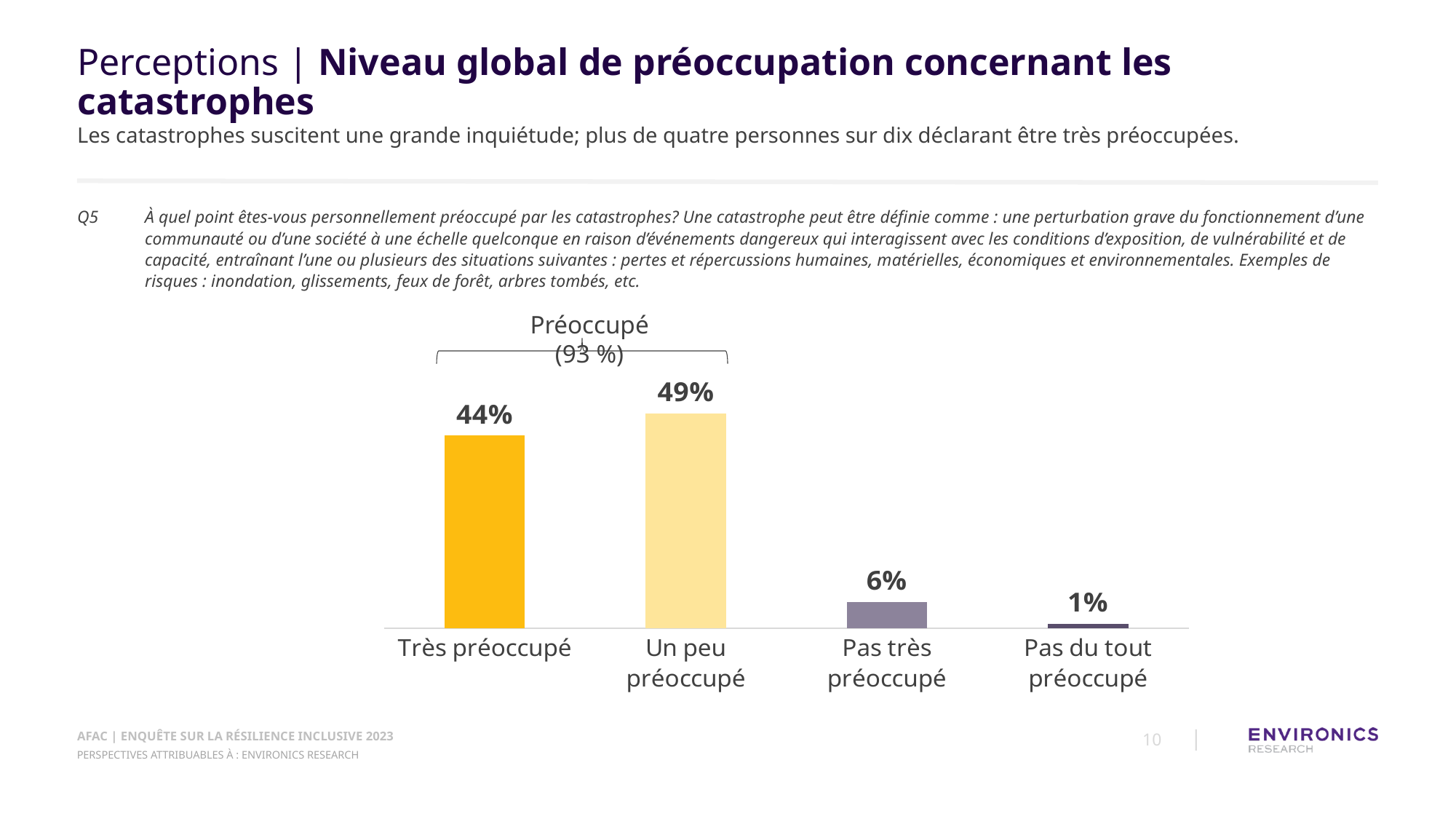
What is the value for "Très préoccupé"? 44% Which is larger, the value for "Pas très préoccupé" or "Pas du tout préoccupé"? Pas très préoccupé What is the value for "Pas très préoccupé"? 6% What is the value for "Un peu préoccupé"? 49% What kind of chart is shown on the slide? Bar chart What combined percentage is shown by the bracket labelled "Préoccupé" above the first two bars? 93 % Which category has the lowest value? Pas du tout préoccupé Which category has the highest value? Un peu préoccupé How many categories are shown in the chart? 4 What is the difference between the values for "Un peu préoccupé" and "Très préoccupé"? 5% What is the value for "Pas du tout préoccupé"? 1% What is the total of the values for "Pas très préoccupé" and "Pas du tout préoccupé"? 7%